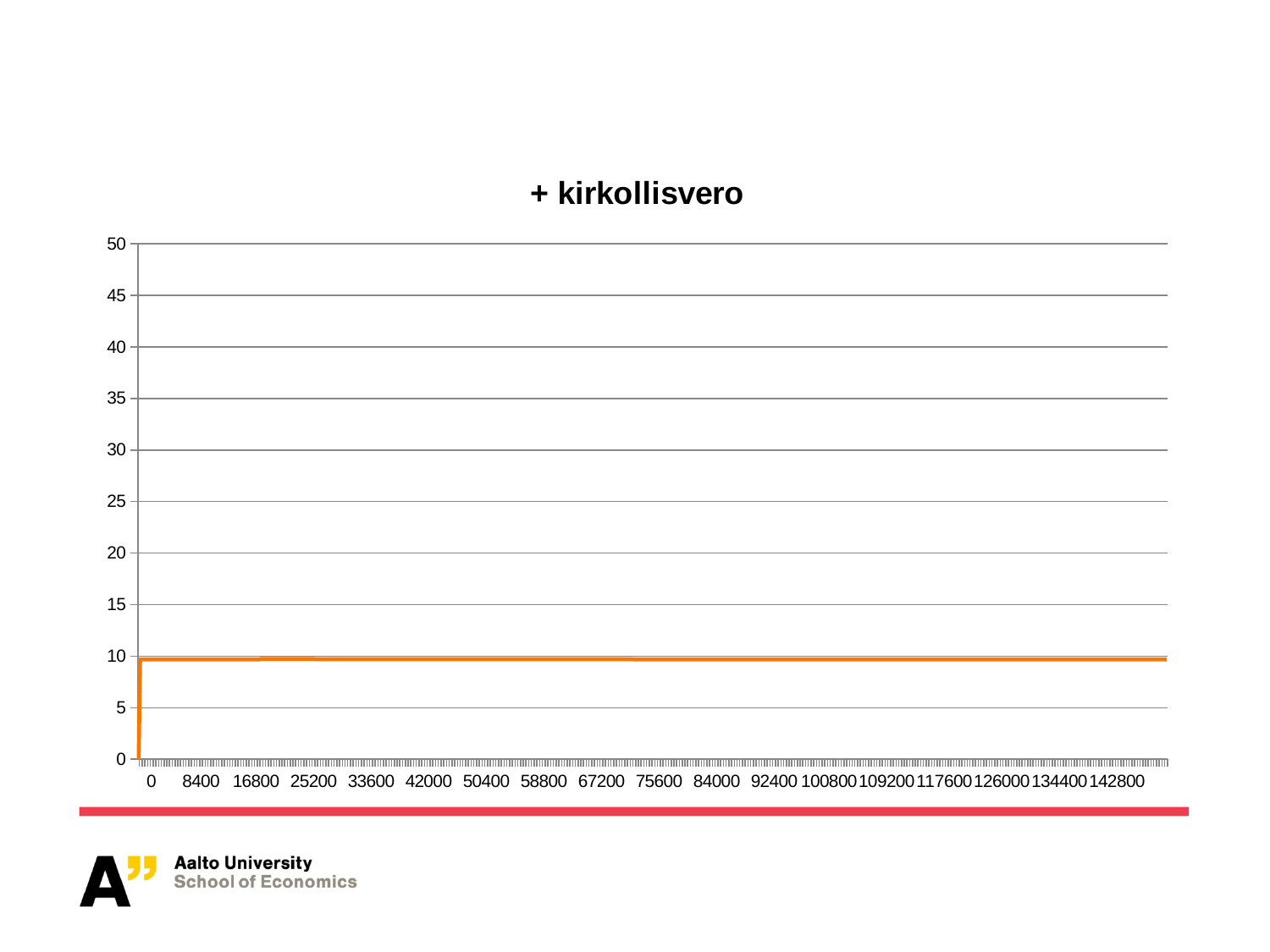
What colour is the plotted line? orange Is the value for 142800 greater or less than 20? less How many labelled tick values are shown on the x axis? 18 After the initial jump at 0, does the line rise, fall or stay flat along the x axis? stay flat What is the highest value shown on the y axis? 50 Is the value for 84000 greater or less than 15? less What is the last labelled value on the x axis? 142800 What kind of chart is shown on the slide? line chart What is the title of the chart? + kirkollisvero Is the value for 42000 greater or less than 5? greater What is the step between consecutive y-axis labels? 5